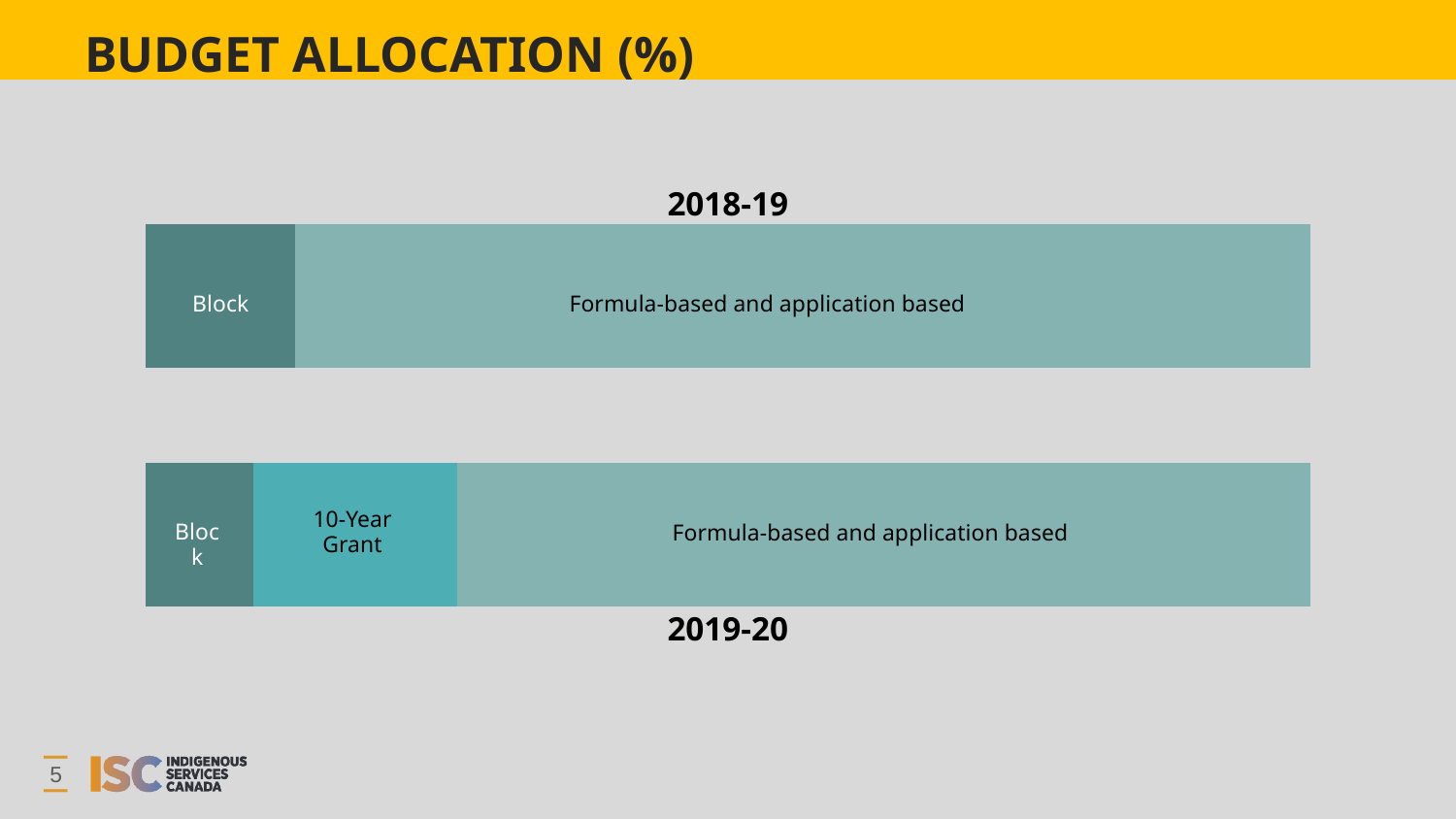
Which segment appears in the 2019-20 bar but not in the 2018-19 bar? 10-Year Grant Which segment is the largest in the 2019-20 bar? Formula-based and application based How many fiscal years (bars) are shown on the slide? 2 What is the title of the slide's chart? BUDGET ALLOCATION (%) How many segments make up the 2019-20 bar? 3 What kind of chart is shown on the slide? Stacked bar chart In the 2018-19 bar, which segment is larger: Block or Formula-based and application based? Formula-based and application based In the 2019-20 bar, which segment is larger: Block or 10-Year Grant? 10-Year Grant Is the Block segment larger in 2018-19 or in 2019-20? 2018-19 How many segments make up the 2018-19 bar? 2 Which segment is the smallest in the 2019-20 bar? Block